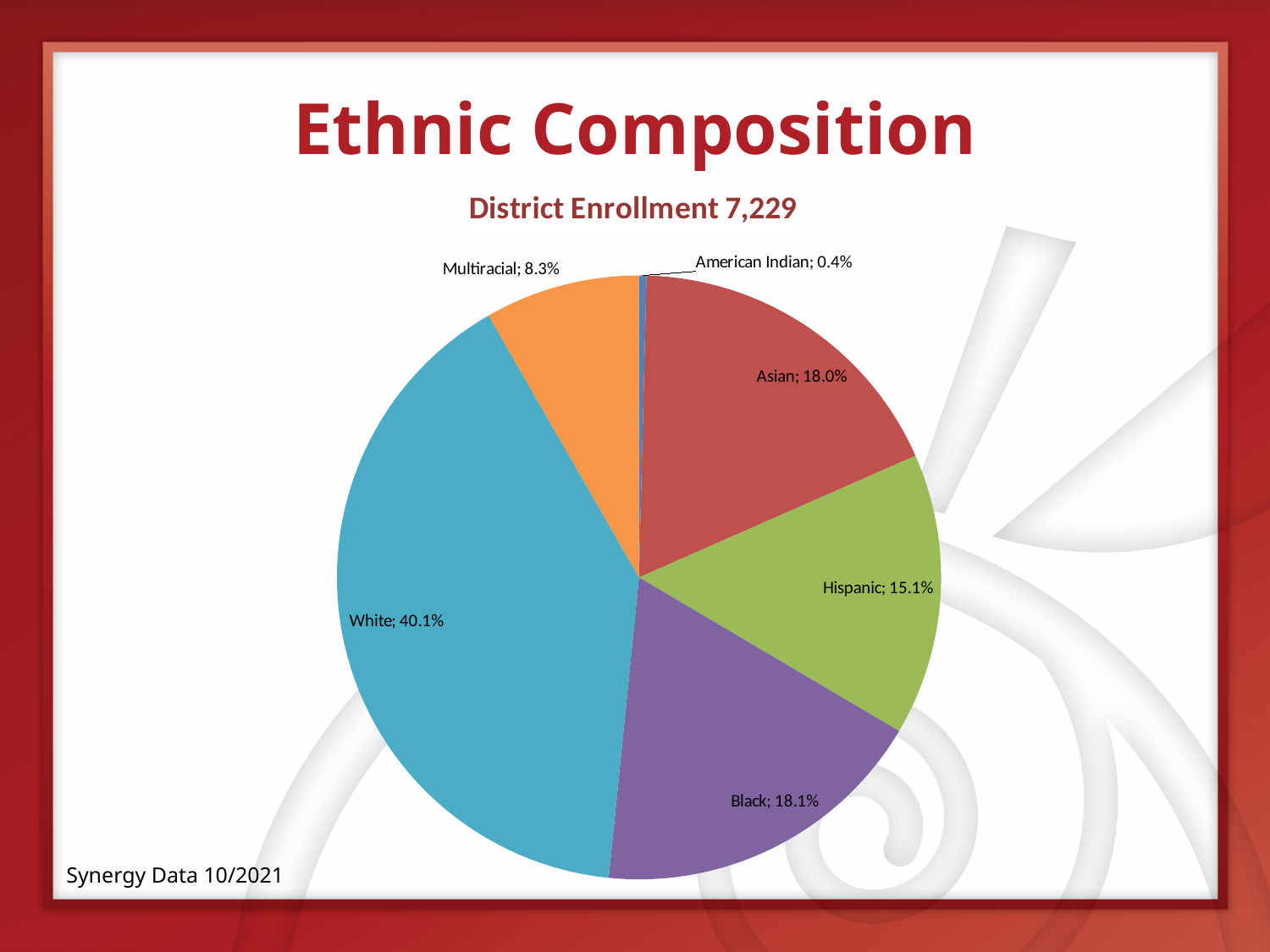
What is the chart's title? District Enrollment 7,229 How many slices does the pie chart have? 6 What percentage of the pie is Multiracial? 8.3% What kind of chart is shown on the slide? pie chart What percentage of the pie is Asian? 18.0% What percentage of the pie is White? 40.1% What is the difference in percentage points between the White and Black slices? 22.0 Which slice is larger, Hispanic or Multiracial? Hispanic Which category has the smallest slice of the pie? American Indian What percentage of the pie is Hispanic? 15.1% What percentage of the pie is American Indian? 0.4% Which category has the largest slice of the pie? White